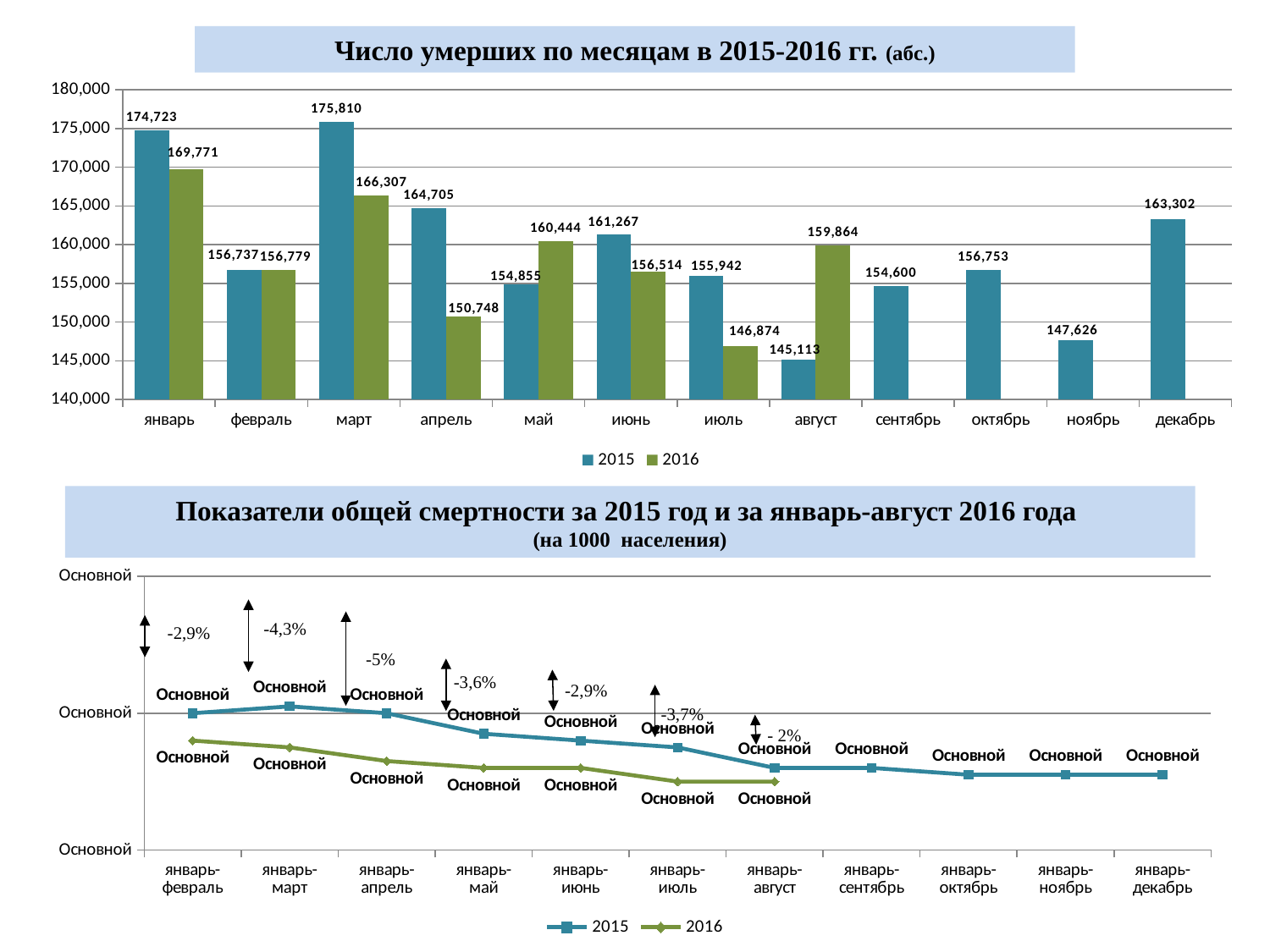
In the bottom chart 'Показатели общей смертности за 2015 год и за январь-август 2016 года', what percentage change is annotated for январь-апрель? -5% In the top chart 'Число умерших по месяцам в 2015-2016 гг.', is the 2015 value for ноябрь greater or less than 150,000? less In the top chart 'Число умерших по месяцам в 2015-2016 гг.', what is the value for 2016 in август? 159,864 In the top chart 'Число умерших по месяцам в 2015-2016 гг.', how many months have a 2016 bar? 8 In the top chart 'Число умерших по месяцам в 2015-2016 гг.', which month has the highest value for 2015? март In the top chart 'Число умерших по месяцам в 2015-2016 гг.', which month has the lowest value for 2016? июль In the top chart 'Число умерших по месяцам в 2015-2016 гг.', what is the value for 2015 in март? 175,810 In the top chart 'Число умерших по месяцам в 2015-2016 гг.', how many series does the legend list? 2 What kind of chart is the top chart 'Число умерших по месяцам в 2015-2016 гг.'? bar chart In the top chart 'Число умерших по месяцам в 2015-2016 гг.', which is larger in май: the 2015 value or the 2016 value? 2016 What kind of chart is the bottom chart 'Показатели общей смертности за 2015 год и за январь-август 2016 года'? line chart In the top chart 'Число умерших по месяцам в 2015-2016 гг.', what is the difference between the 2015 and 2016 values in январь? 4,952